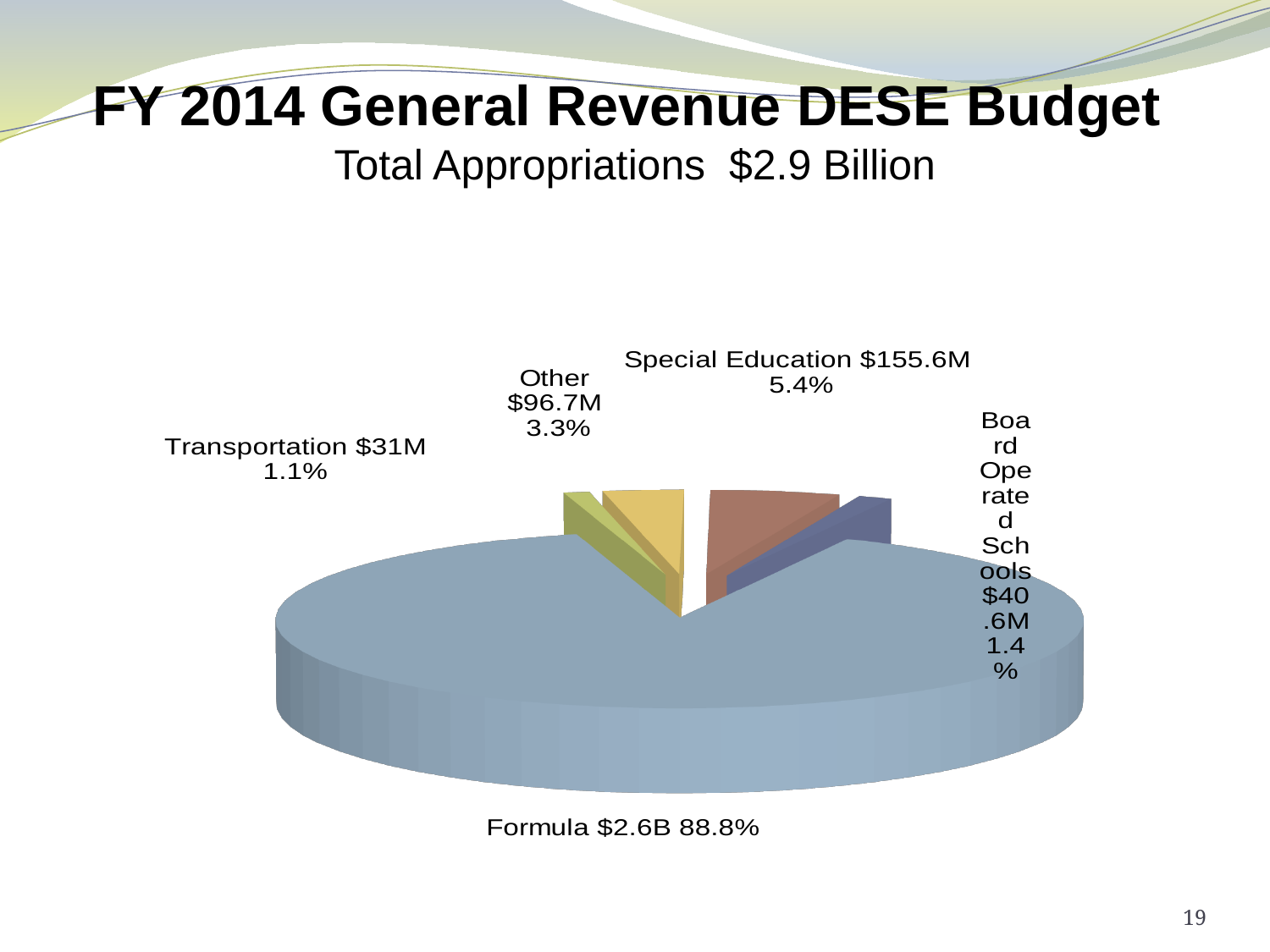
How many slices does the pie chart have? 5 What kind of chart is shown on the slide? Pie chart Which category has the smallest share of the pie? Transportation Which is larger, the share for Other or the share for Special Education? Special Education Which category has the largest share of the pie? Formula What percentage of the budget is Special Education? 5.4% What share of the pie does Formula represent? 88.8% What is the difference in percentage points between the Special Education share and the Other share? 2.1% What is the dollar amount shown for Transportation? $31M What percentage of the budget is Board Operated Schools? 1.4% What is the dollar amount shown for Special Education? $155.6M What is the dollar amount shown for Other? $96.7M